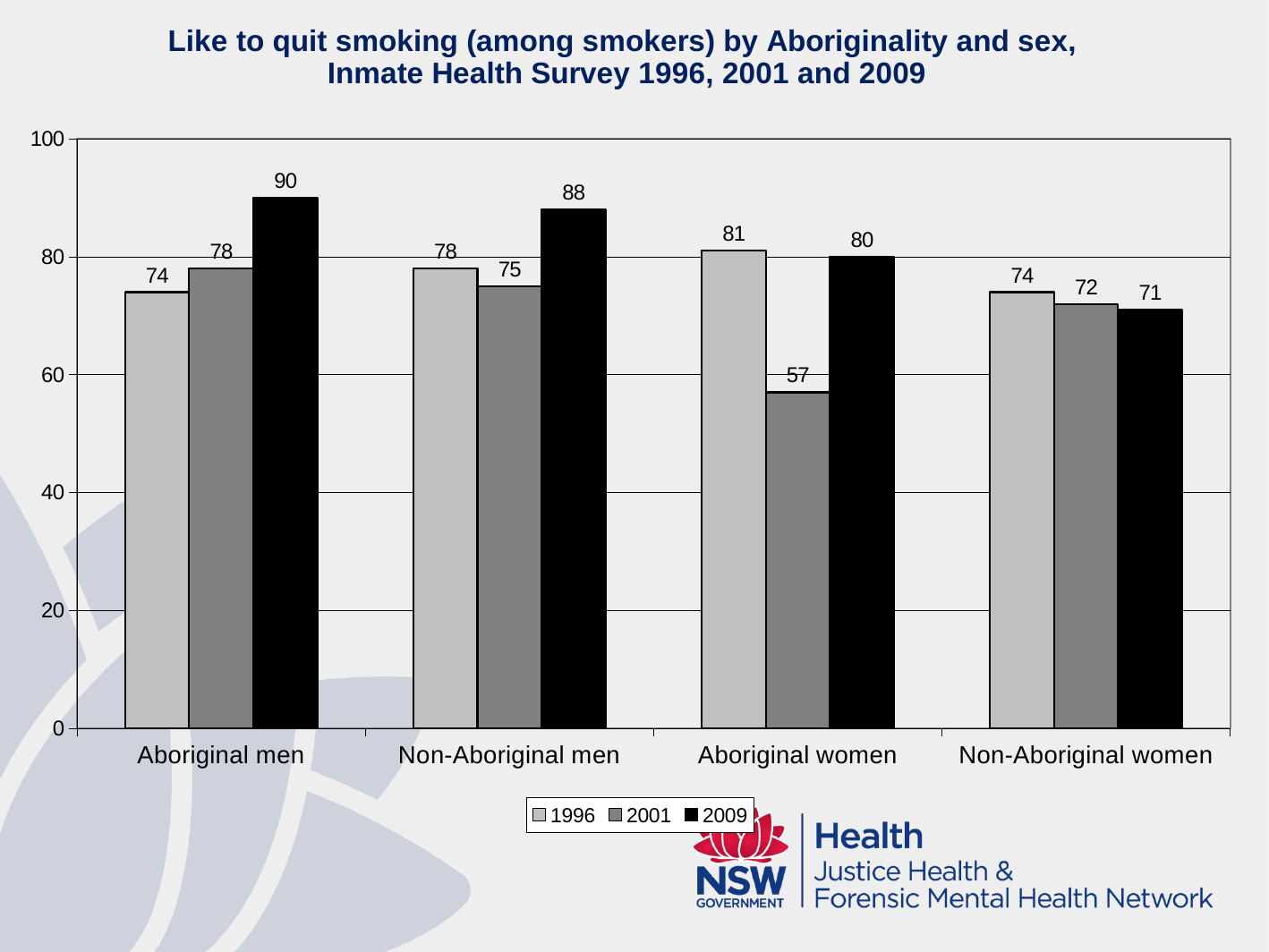
Do the values for Non-Aboriginal women rise or fall from 1996 to 2009? fall Which category has the lowest 2001 value? Aboriginal women Which category has the highest 2009 value? Aboriginal men What is the 2009 value for Aboriginal men? 90 What is the difference between the 2009 and 1996 values for Non-Aboriginal men? 10 What is the 2001 value for Aboriginal women? 57 How many categories are shown on the x axis? 4 Which is larger for Aboriginal women: the 1996 value or the 2001 value? 1996 Is the 2009 value for Non-Aboriginal women greater or less than 80? less What kind of chart is shown on the slide? bar chart How many series does the legend list? 3 What is the 1996 value for Non-Aboriginal women? 74